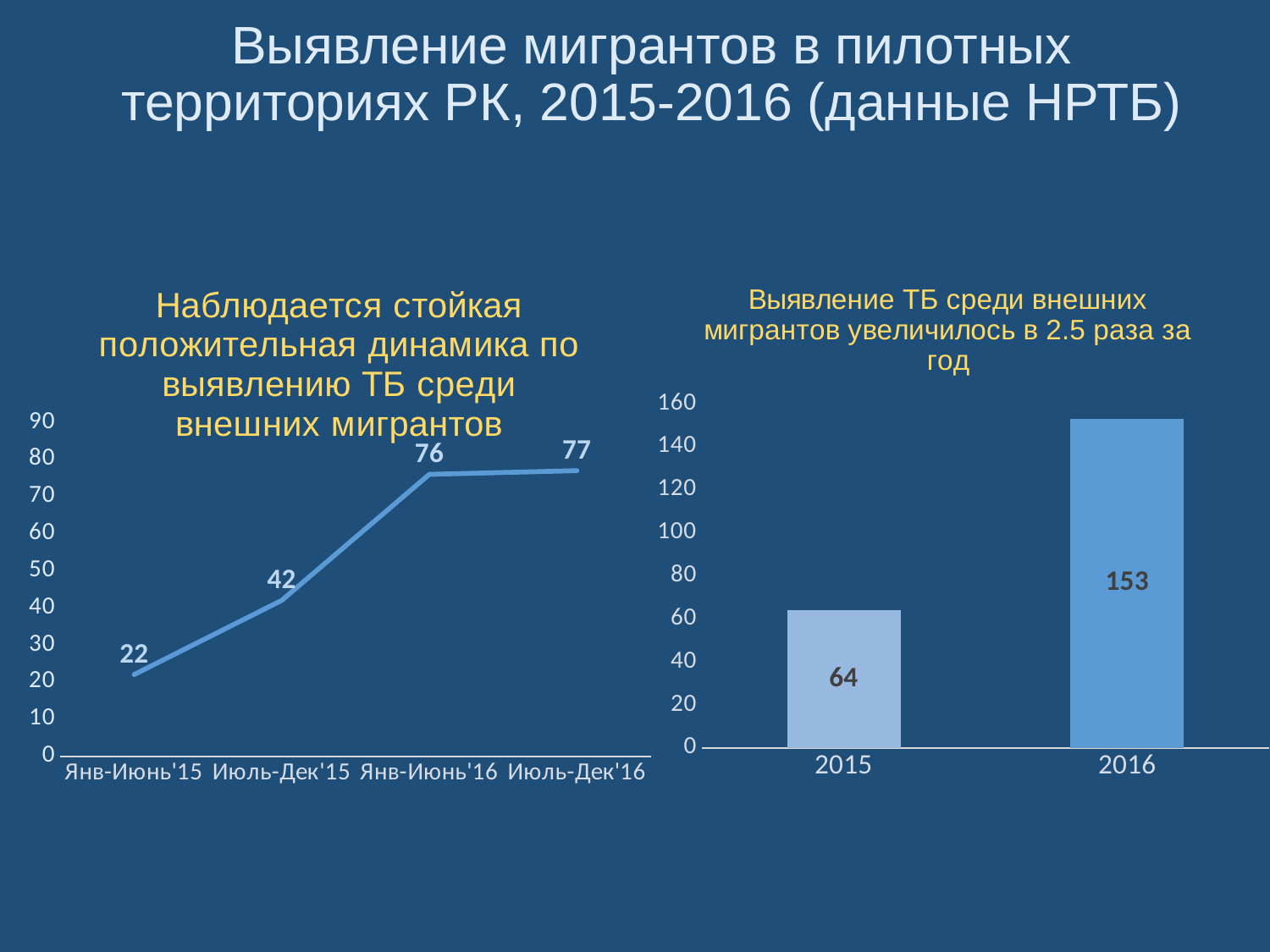
In the left chart, how many periods are plotted? 4 In the left chart, what is the value for Июль-Дек'15? 42 In the left chart, what is the value for Янв-Июнь'16? 76 In the right chart, what is the value for 2015? 64 In the left chart, what is the difference between the values for Янв-Июнь'16 and Июль-Дек'15? 34 In the right chart, what is the difference between the values for 2016 and 2015? 89 What kind of chart is the left chart? line chart In the left chart, which period has the lowest value? Янв-Июнь'15 In the left chart, what is the value for Янв-Июнь'15? 22 In the left chart, do the values rise or fall from Янв-Июнь'15 to Июль-Дек'16? rise What kind of chart is the right chart? bar chart In the right chart, what is the value for 2016? 153